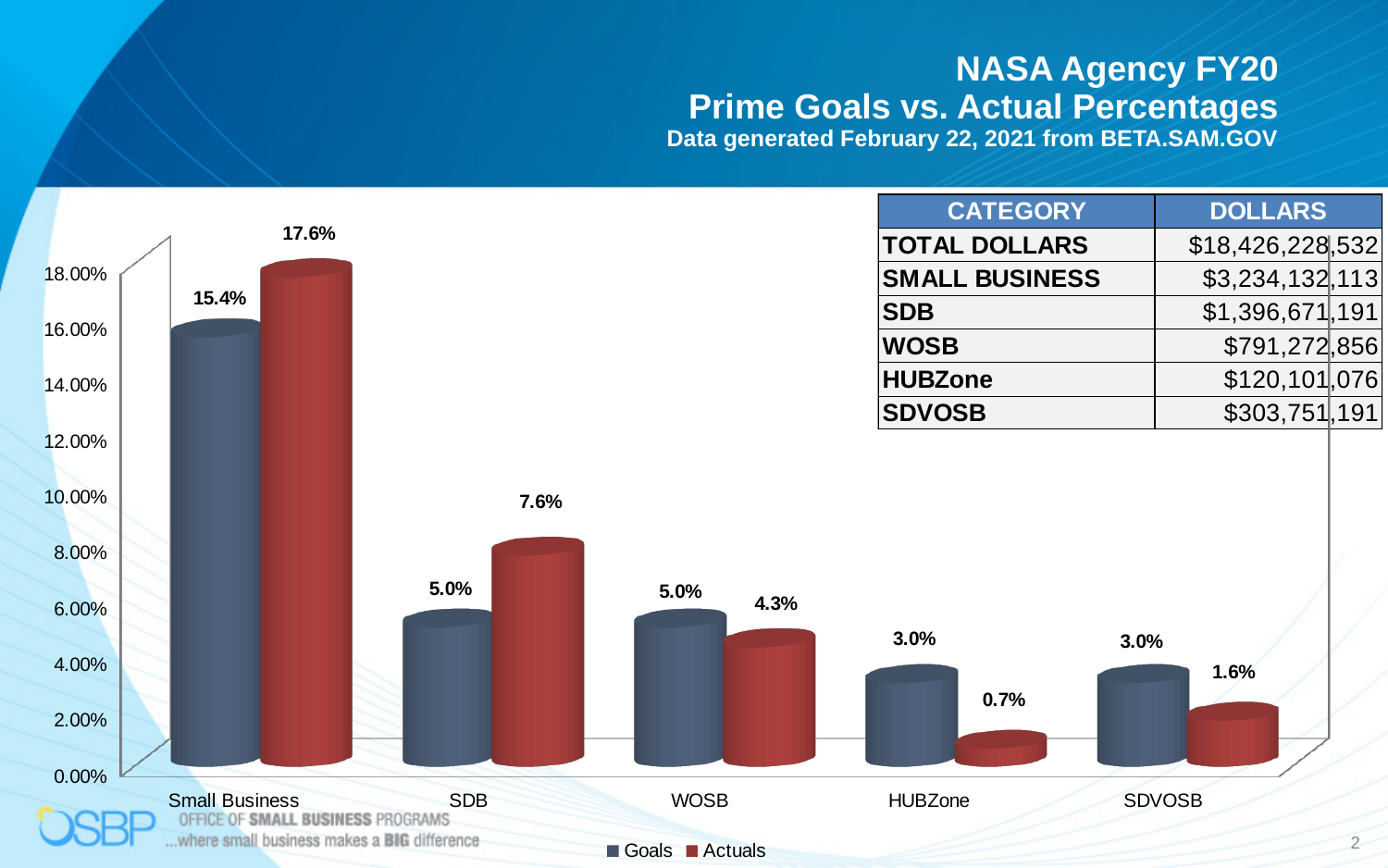
What is the Actuals value for HUBZone? 0.7% How many series does the legend list? 2 What is the difference between the Actuals and Goals values for SDB? 2.6% Which is larger for WOSB, the Goals value or the Actuals value? Goals What is the Actuals value for Small Business? 17.6% Which colour represents the Actuals series in the chart? Red Which category has the lowest Actuals value? HUBZone What kind of chart is shown on the slide? Bar chart What is the Goals value for SDB? 5.0% Is the Actuals value for SDVOSB greater or less than 2.00%? less How many categories are shown on the x axis? 5 Which category has the highest Actuals value? Small Business